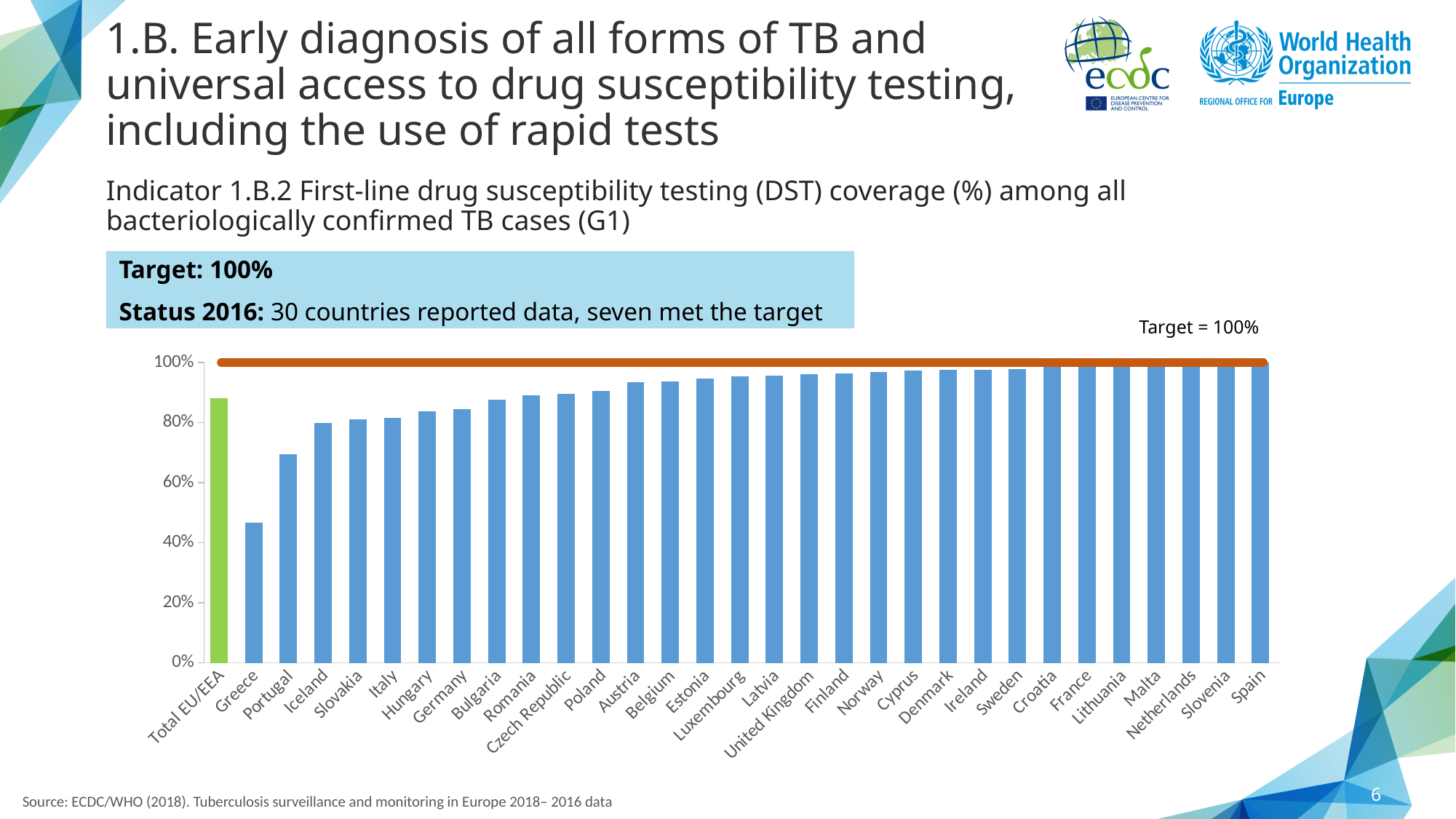
Which country has the lowest first-line DST coverage in the chart? Greece Which has the higher value, Greece or Portugal? Portugal What kind of chart is shown on the slide? bar chart What is the first-line DST coverage value for Spain? 100% Is the value for Portugal greater or less than 60%? greater Excluding the Total EU/EEA bar, how many countries are plotted in the chart? 30 What is the first-line DST coverage value for Malta? 100% Is the value for Total EU/EEA greater or less than 80%? greater Is the value for Austria greater or less than 80%? greater Which has the higher value, Italy or Austria? Austria What value does the horizontal target line in the chart represent? 100%